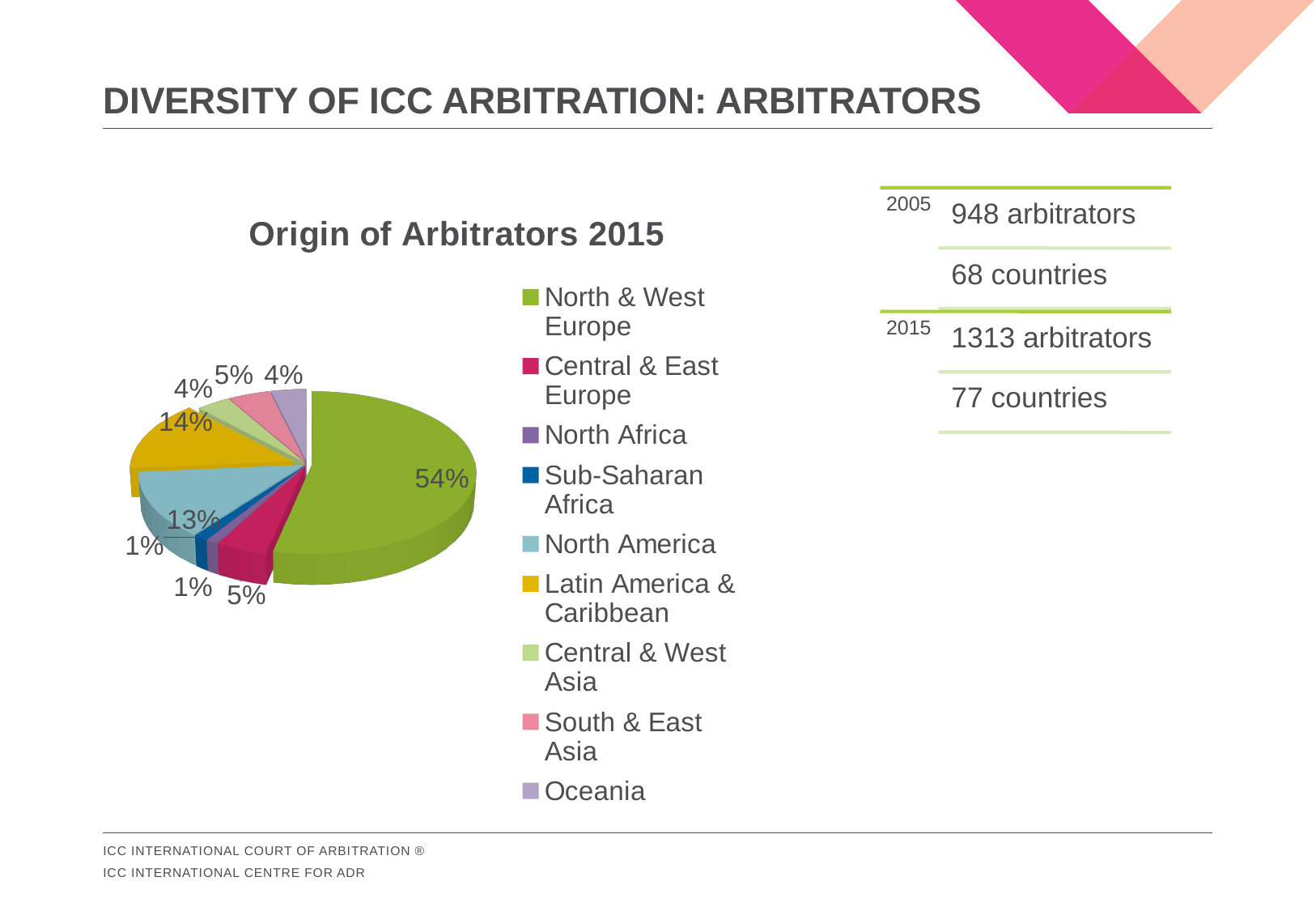
Which region has the largest share of arbitrators in the chart? North & West Europe What kind of chart is shown on the slide? pie chart What is the difference between the shares for North & West Europe and North America? 41% What share of arbitrators in 2015 came from North & West Europe? 54% What share of arbitrators in 2015 came from Central & East Europe? 5% How many regions are listed in the chart's legend? 9 What share of arbitrators in 2015 came from Oceania? 4% Which has a larger share, Latin America & Caribbean or North America? Latin America & Caribbean What share of arbitrators in 2015 came from Latin America & Caribbean? 14% What share of arbitrators in 2015 came from North America? 13% What is the combined share of North Africa and Sub-Saharan Africa? 2% What is the title of the chart? Origin of Arbitrators 2015